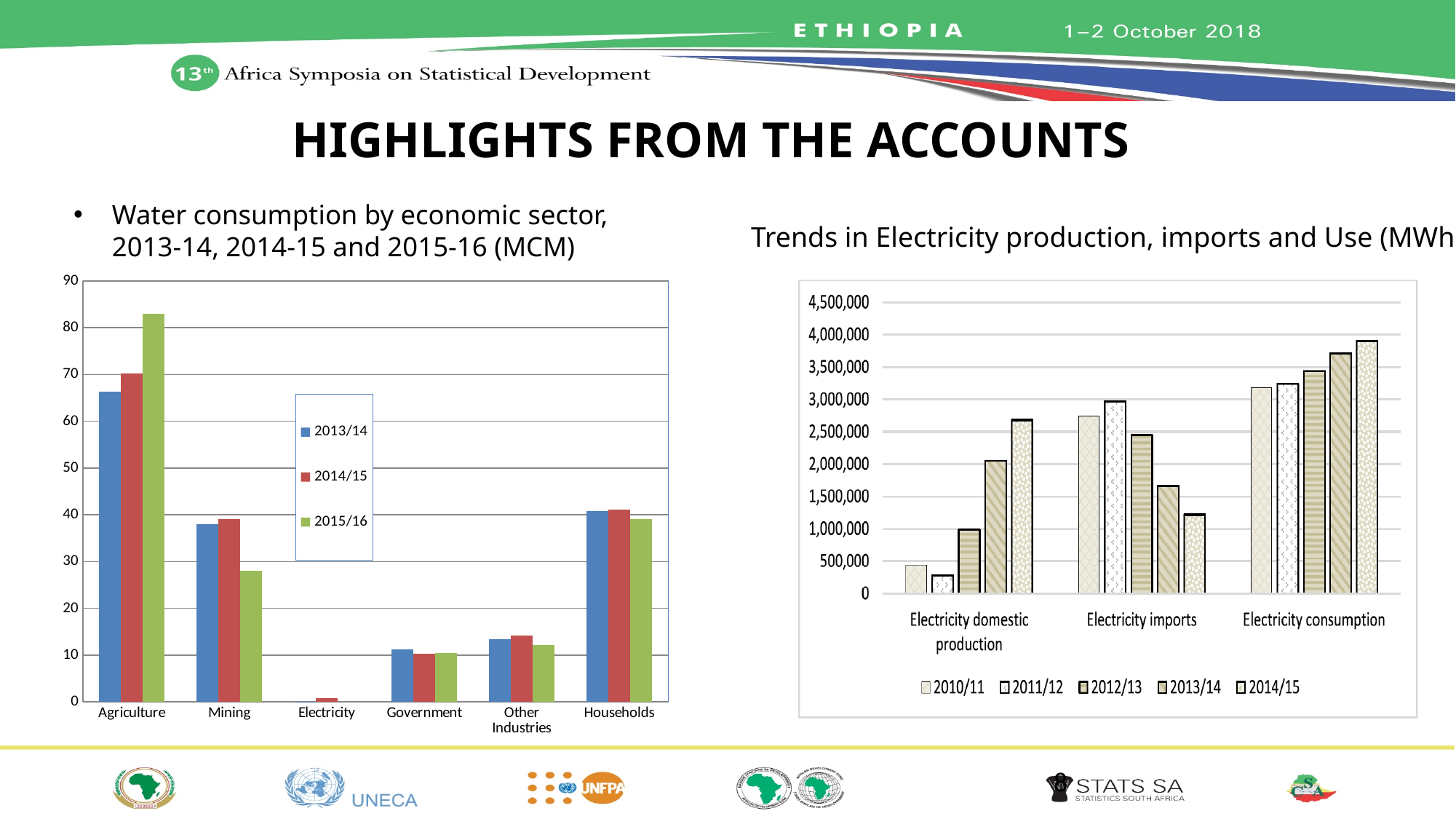
In the electricity chart on the right, is the value for Electricity imports in 2014/15 greater or less than 1,000,000? greater In the water consumption chart on the left, is the value for Agriculture in 2013/14 greater or less than 60? greater In the water consumption chart on the left, is the value for Mining in 2015/16 greater or less than 30? less How many economic sectors are shown in the water consumption chart on the left? 6 In the water consumption chart on the left, which sector has the tallest bar? Agriculture In the water consumption chart on the left, which is larger for Mining: 2013/14 or 2015/16? 2013/14 In the water consumption chart on the left, which sector has the lowest water consumption? Electricity What kind of chart is the 'Trends in Electricity production, imports and Use' chart on the right? bar chart How many series does the legend of the water consumption chart on the left list? 3 In the electricity chart on the right, how many years does the legend list? 5 In the electricity chart on the right, do the Electricity consumption values rise or fall from 2010/11 to 2014/15? rise